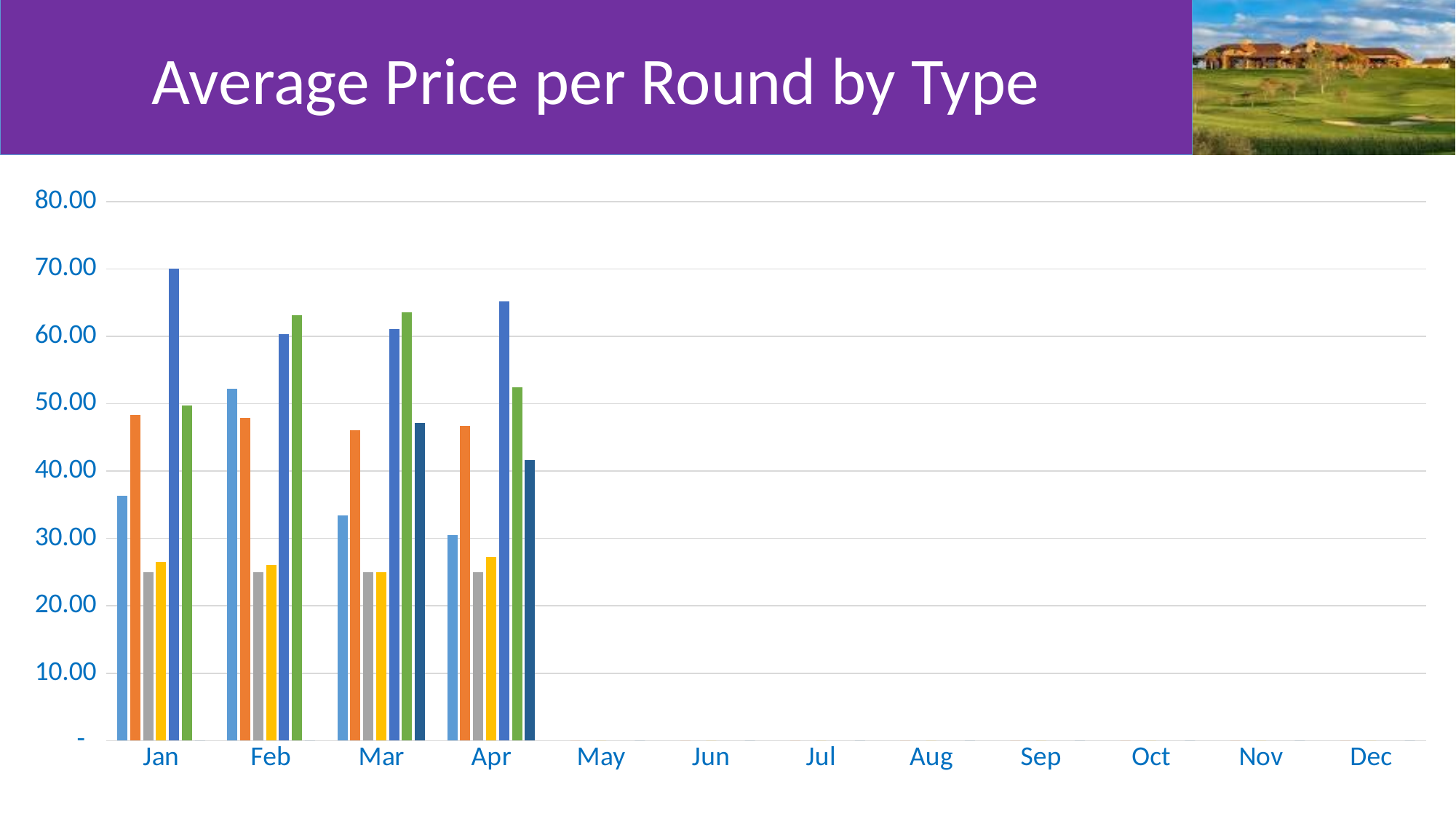
In Jan, which is larger: the blue bar or the green bar? the blue bar How many differently coloured bars are plotted for Mar? 7 Which month has the tallest light blue bar? Feb Is the value of the dark blue bar for Apr greater or less than 50? less What is the title of the chart? Average Price per Round by Type Is the value of the gray bar for Feb greater or less than 30? less Which month has the tallest bar overall? Jan What kind of chart is shown on the slide? bar chart Is the value of the blue bar for Jan greater or less than 60? greater How many months are labelled on the x axis? 12 Which month has the shortest light blue bar? Apr How many months have bars plotted? 4